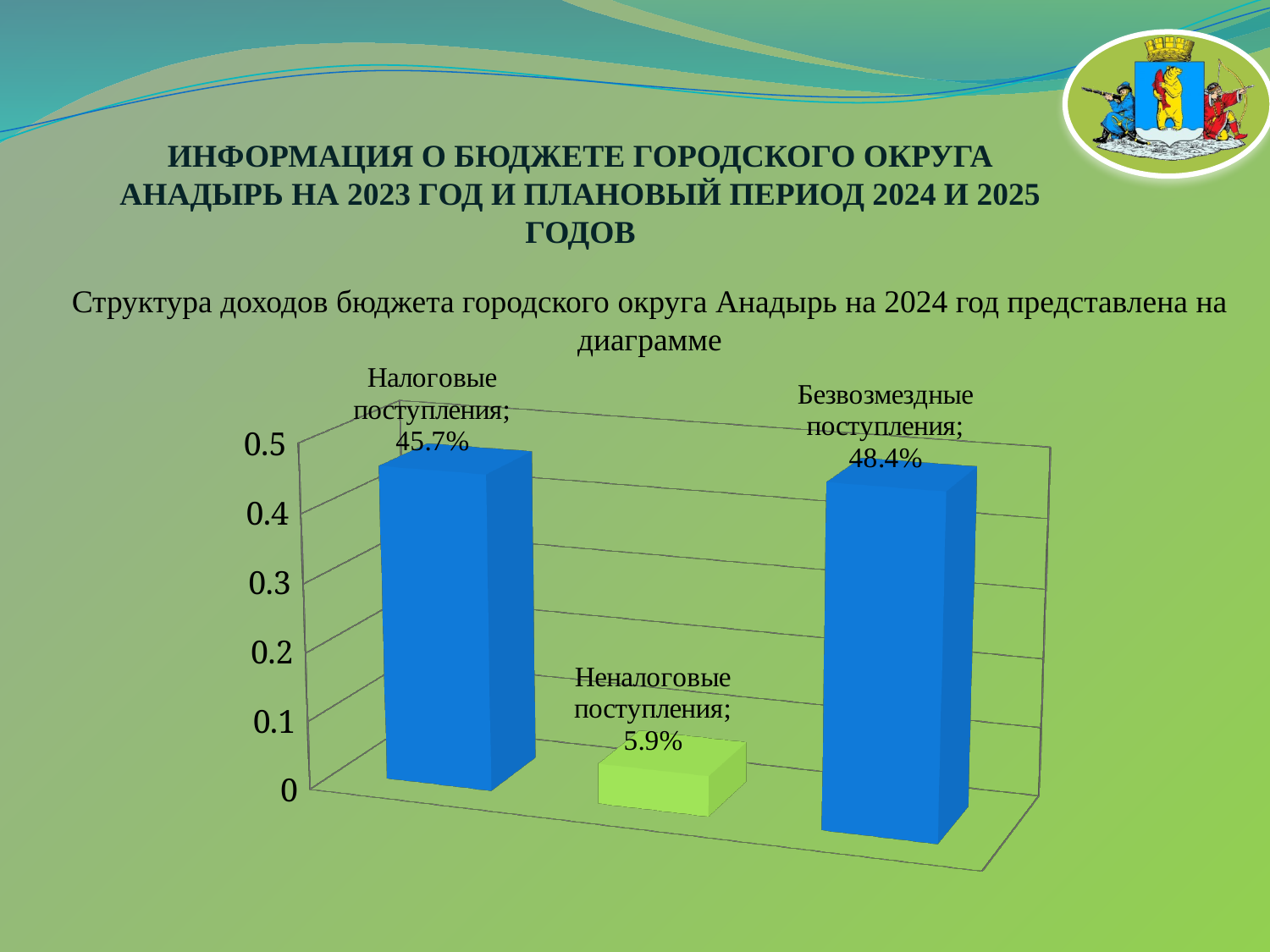
What kind of chart is shown on the slide? bar chart What is the highest tick value shown on the vertical axis? 0.5 What is the difference between Налоговые поступления and Неналоговые поступления? 39.8% Which category has the highest value? Безвозмездные поступления Which is larger, Налоговые поступления or Неналоговые поступления? Налоговые поступления What is the difference between Безвозмездные поступления and Налоговые поступления? 2.7% What is the value for Неналоговые поступления? 5.9% Which category has the lowest value? Неналоговые поступления Is the value for Неналоговые поступления greater or less than 0.1? less What is the value for Безвозмездные поступления? 48.4% How many categories are shown in the chart? 3 What is the value for Налоговые поступления? 45.7%